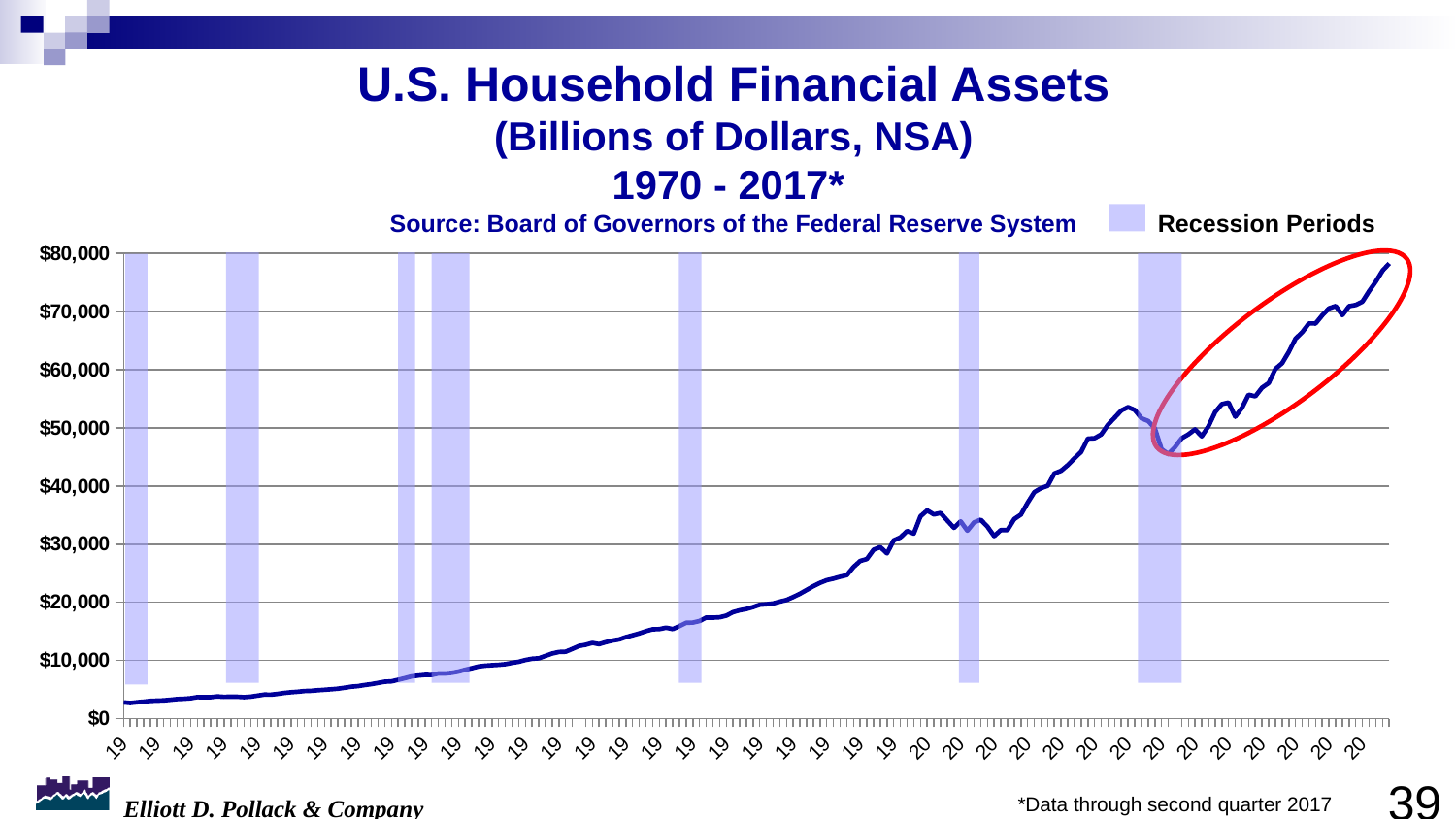
Is the value at the end of the series (2017) greater or less than $70,000? greater How many data series are plotted as lines on the chart? 1 Is the value at the end of the series greater or less than $80,000? less What is the title of the chart? U.S. Household Financial Assets (Billions of Dollars, NSA) 1970 - 2017* What is the highest value shown on the y-axis? $80,000 How many recession periods are shaded on the chart? 7 Is the value at the end of the series higher or lower than the value at the start of the series? higher Is the peak reached around 2000 greater or less than $30,000? greater Overall, do household financial assets rise or fall from 1970 to 2017? rise What kind of chart is shown on the slide? line chart What do the shaded vertical bands on the chart represent, according to the legend? Recession Periods